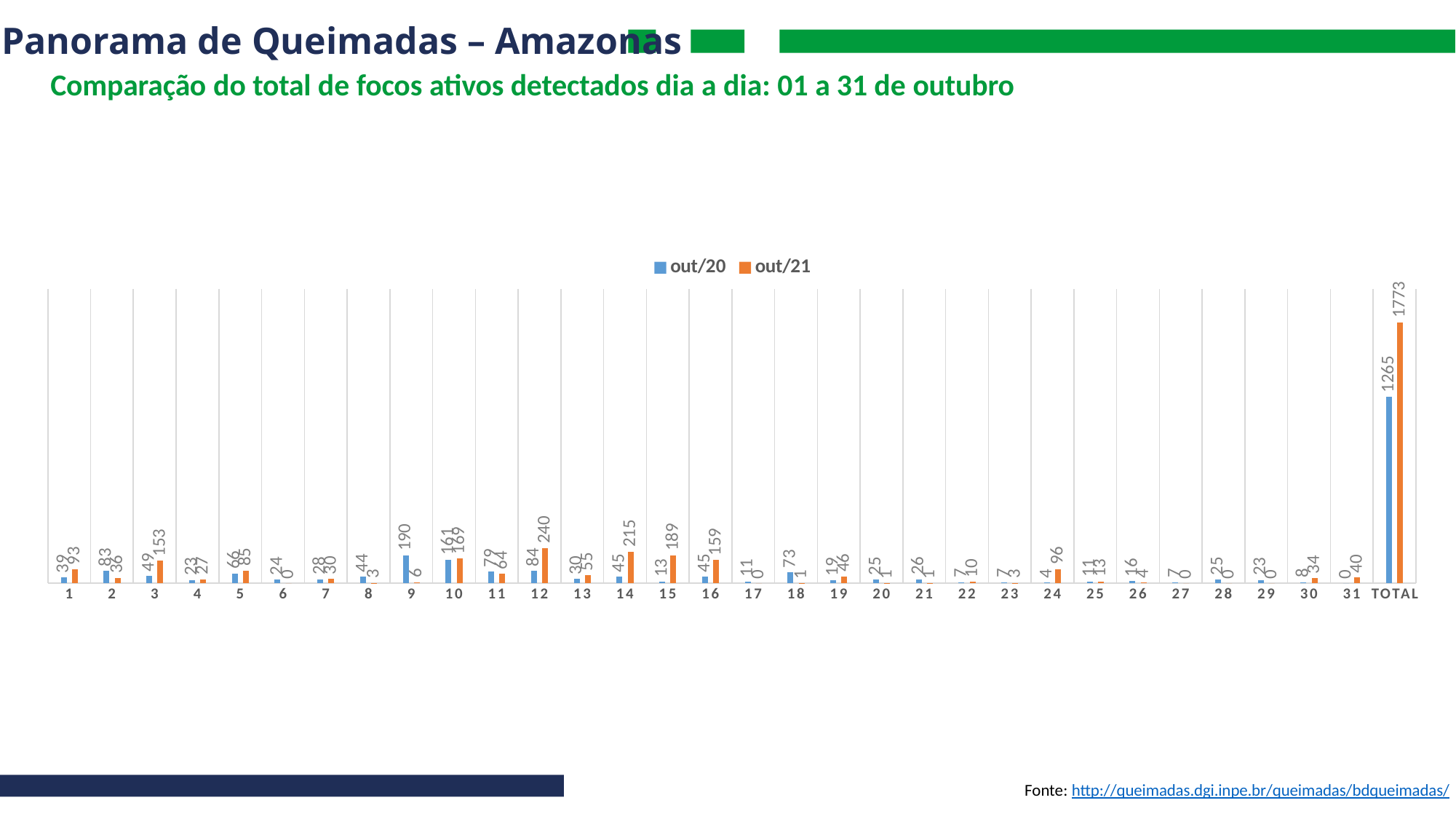
What is the out/20 value for the TOTAL category? 1265 What is the out/20 value for day 9? 190 What kind of chart is shown on the slide? bar chart What is the out/21 value for day 12? 240 How many series does the legend list? 2 Excluding the TOTAL category, which day has the highest out/20 value? 9 Excluding the TOTAL category, which day has the highest out/21 value? 12 What is the difference between the out/21 and out/20 values for day 15? 176 How many categories are shown on the x axis, including TOTAL? 32 What is the out/21 value for the TOTAL category? 1773 For day 3, which series has the larger value, out/20 or out/21? out/21 What is the difference between the out/21 and out/20 values for TOTAL? 508